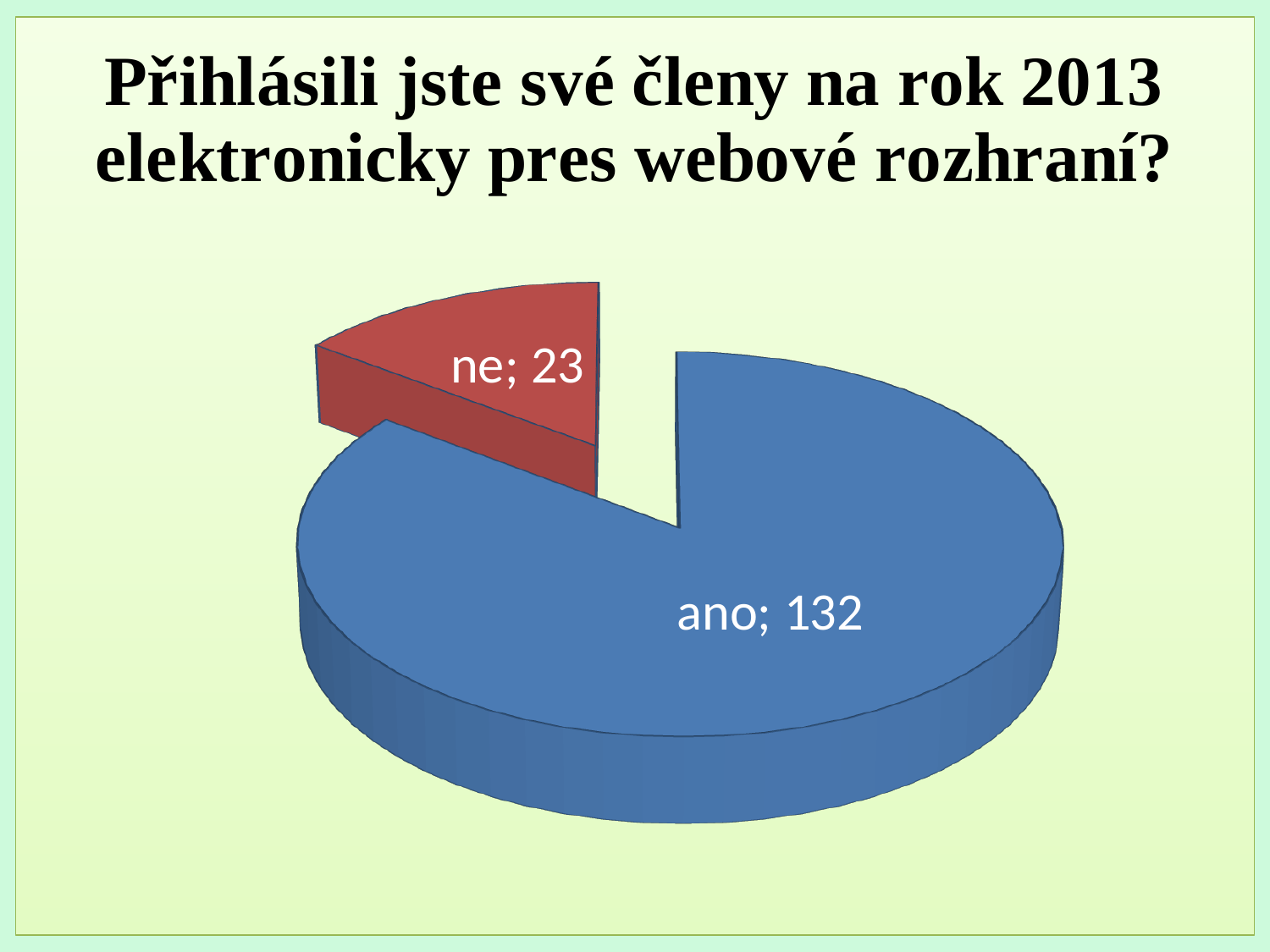
What is the value for the "ano" slice? 132 What is the value for the "ne" slice? 23 What colour is the "ne" slice? red Which category has the smallest slice? ne What is the title of the chart? Přihlásili jste své členy na rok 2013 elektronicky pres webové rozhraní? What is the difference between the "ano" and "ne" values? 109 What is the total of all slices in the pie chart? 155 Which category has the largest slice? ano Which is larger, the value for "ano" or the value for "ne"? ano What type of chart is shown on the slide? pie chart What share of the pie does the "ano" slice represent? 85% How many slices does the pie chart have? 2